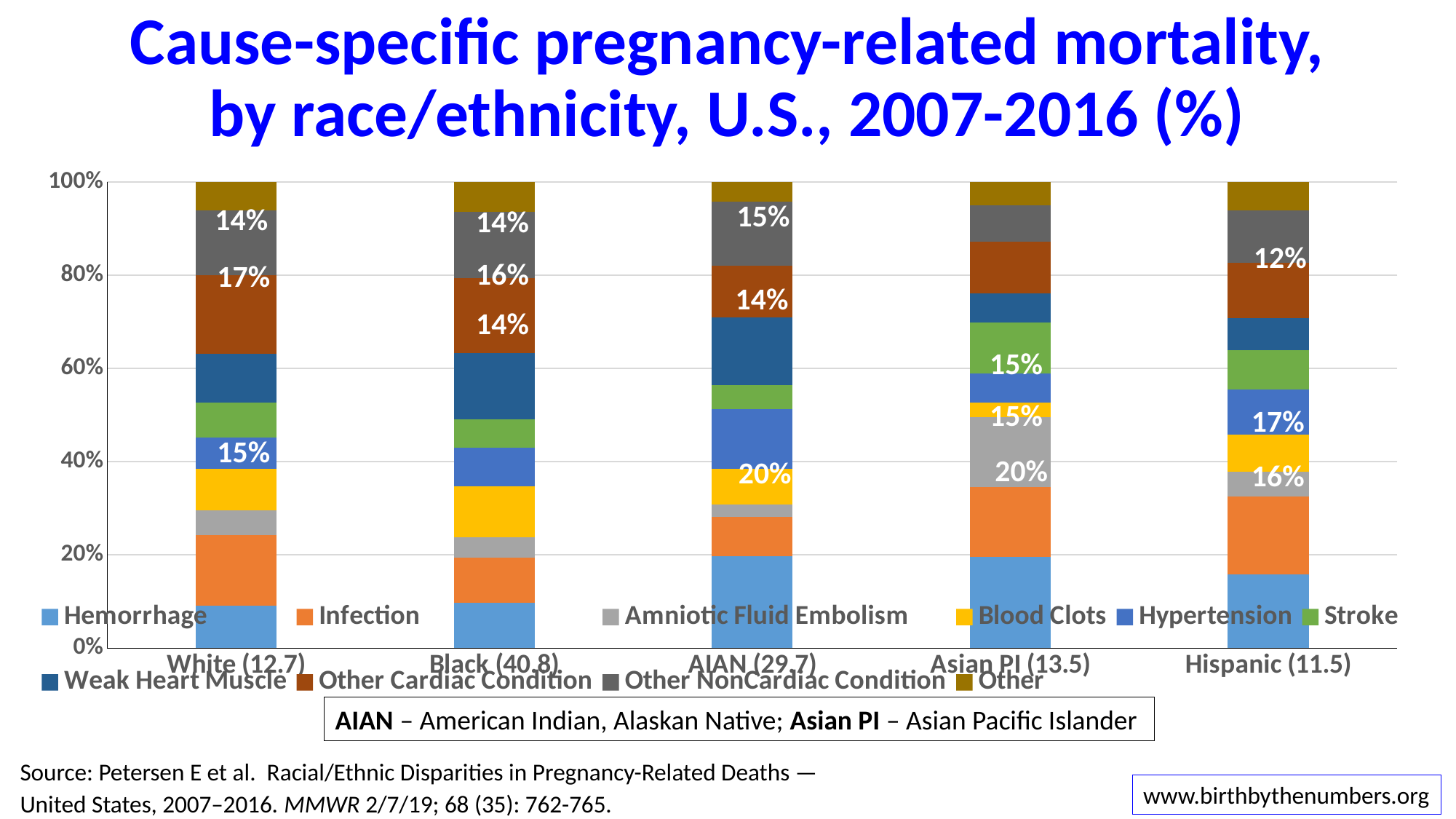
How many series does the legend list? 10 Which bar has the larger Hemorrhage share, AIAN (29.7) or White (12.7)? AIAN (29.7) What is the labelled value for Other NonCardiac Condition in the Hispanic (11.5) bar? 12% How many race/ethnicity categories are shown on the x axis? 5 Is the Hemorrhage share for White (12.7) greater or less than 20%? less What type of chart is shown on the slide? Stacked bar chart What is the labelled value for Other NonCardiac Condition in the Black (40.8) bar? 14% What is the labelled value for Other Cardiac Condition in the Black (40.8) bar? 16% According to the note on the slide, what does AIAN stand for? American Indian, Alaskan Native What is the labelled value for Other NonCardiac Condition in the AIAN (29.7) bar? 15% What does each stacked bar total? 100% What is the labelled value for Other Cardiac Condition in the White (12.7) bar? 17%